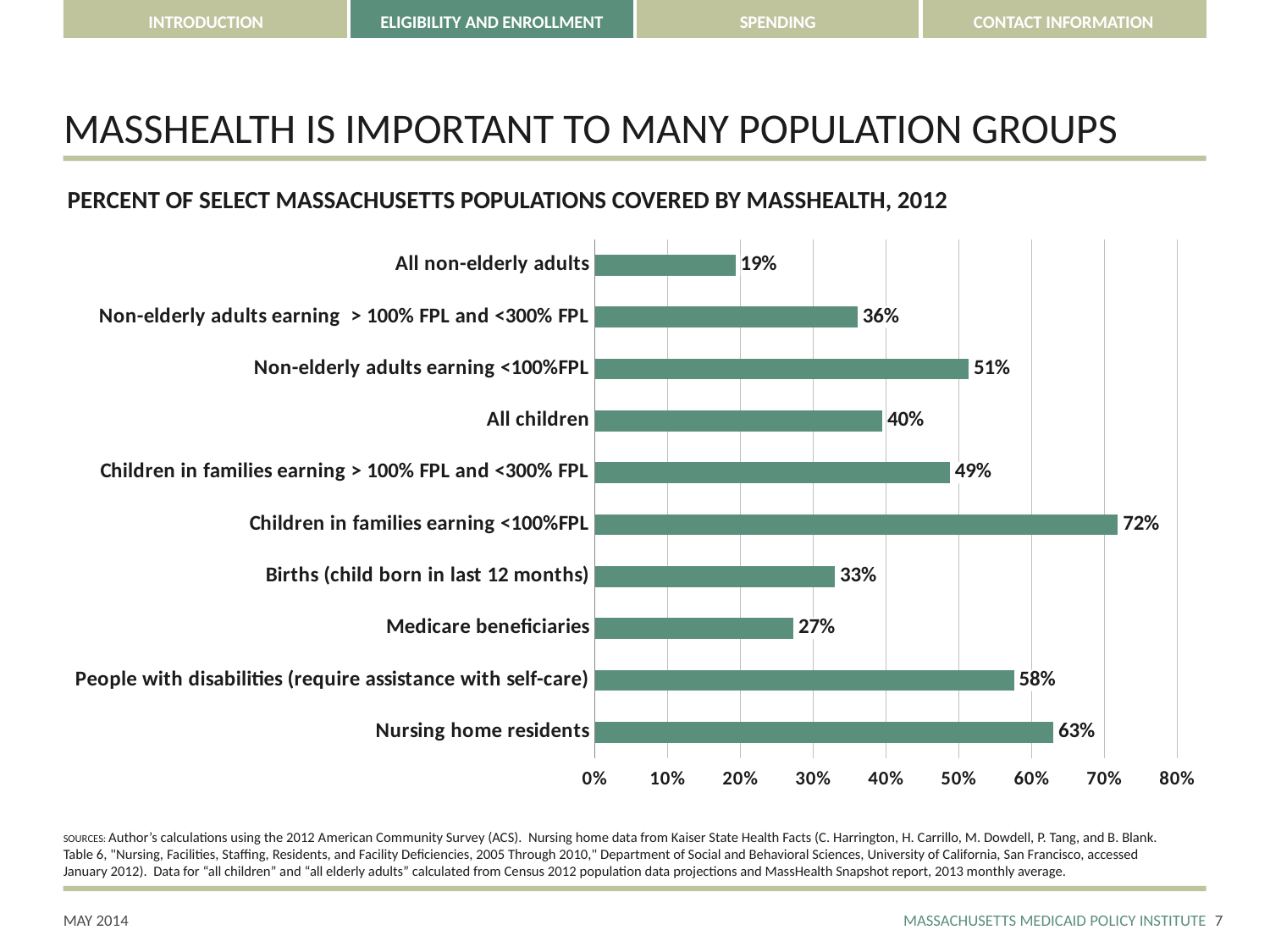
What kind of chart is shown on the slide? Bar chart What is the difference between the value for Children in families earning <100%FPL and the value for All children? 32% What percent of nursing home residents are covered by MassHealth? 63% Which population group has the lowest percent covered by MassHealth? All non-elderly adults What is the difference between the value for Nursing home residents and the value for People with disabilities (require assistance with self-care)? 5% Is the value for Births (child born in last 12 months) greater or less than 40%? less What is the value for Medicare beneficiaries? 27% What percent of all children are covered by MassHealth? 40% Which is larger: the value for Non-elderly adults earning <100%FPL or the value for Children in families earning > 100% FPL and <300% FPL? Non-elderly adults earning <100%FPL What is the title of the chart? Percent of select Massachusetts populations covered by MassHealth, 2012 Which population group has the highest percent covered by MassHealth? Children in families earning <100%FPL How many population groups are shown in the chart? 10